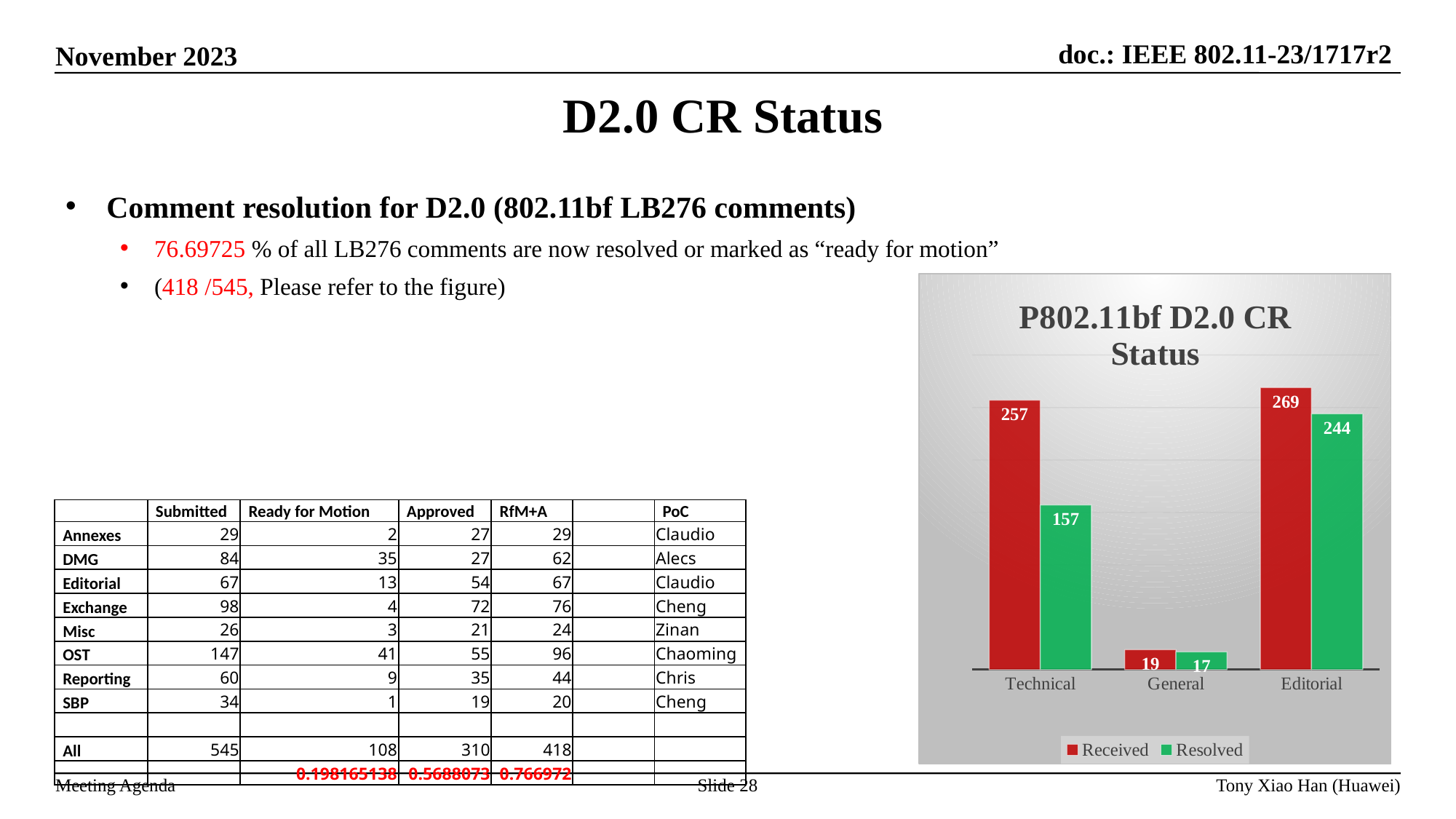
Which category has the highest Received value in the chart? Editorial What is the difference between Received and Resolved for Technical in the chart? 100 What kind of chart is shown on the slide? Bar chart How many categories are shown on the x axis of the chart? 3 Which is larger in the chart: Resolved for Technical or Resolved for Editorial? Resolved for Editorial How many series does the chart legend list? 2 What is the Received value for Technical in the P802.11bf D2.0 CR Status chart? 257 What is the Resolved value for General in the chart? 17 What is the title of the chart on the slide? P802.11bf D2.0 CR Status Which category has the lowest Resolved value in the chart? General What is the difference between Received and Resolved for Editorial in the chart? 25 What is the Resolved value for Editorial in the chart? 244